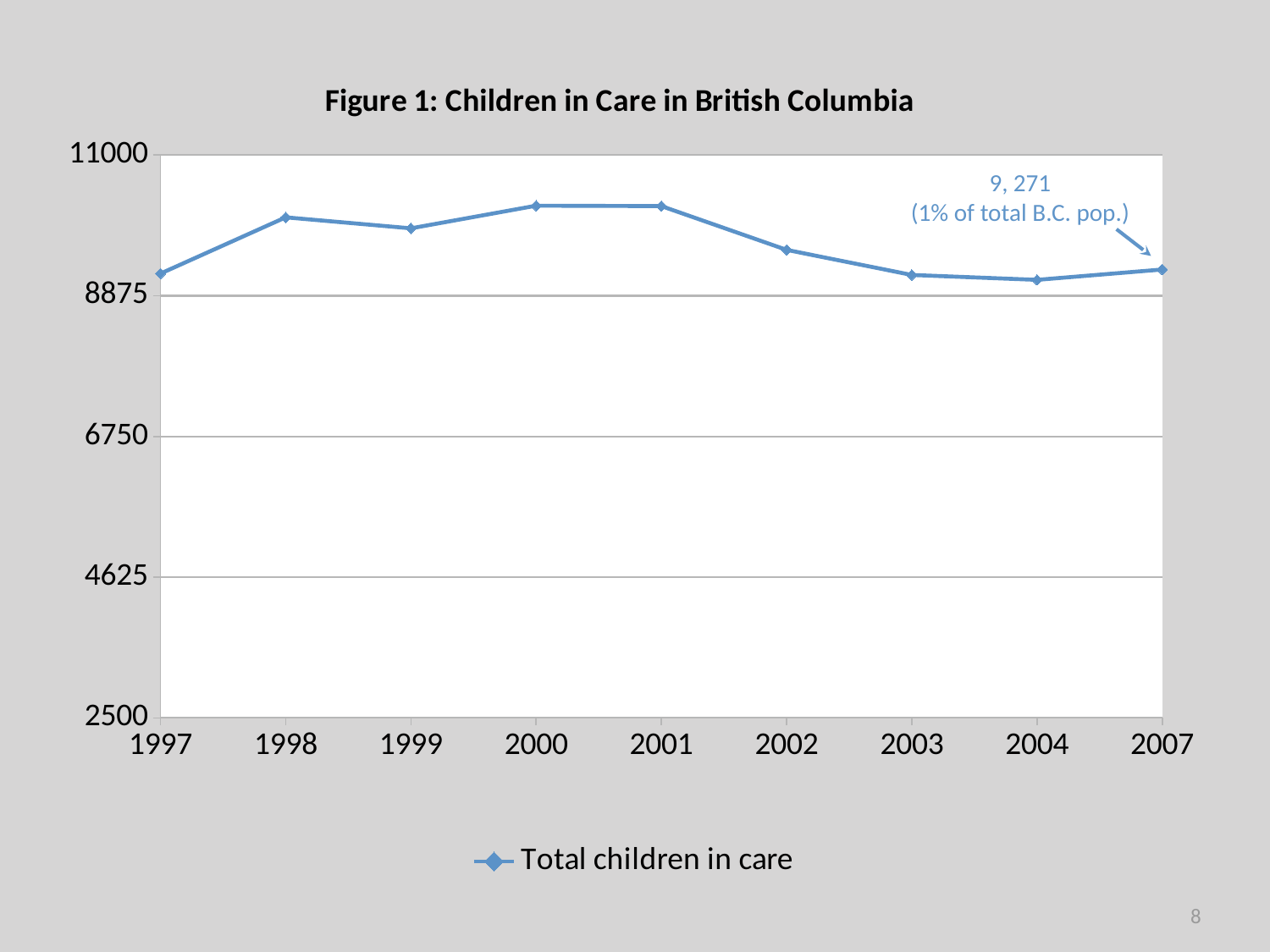
Do the values rise or fall from 1997 to 1998? rise Do the values rise or fall from 2001 to 2004? fall Is the value for 2004 greater or less than 11000? less What is the value labelled for 2007 on the chart? 9, 271 According to the annotation, what share of the total B.C. population does the 2007 value represent? 1% Is the value for 1998 greater or less than 8875? greater What kind of chart is shown on the slide? line chart How many years are plotted along the x axis? 9 How many series does the legend list? 1 Which year has the higher value, 1998 or 2002? 1998 What is the name of the series shown in the legend? Total children in care Which year has the higher value, 2000 or 1997? 2000